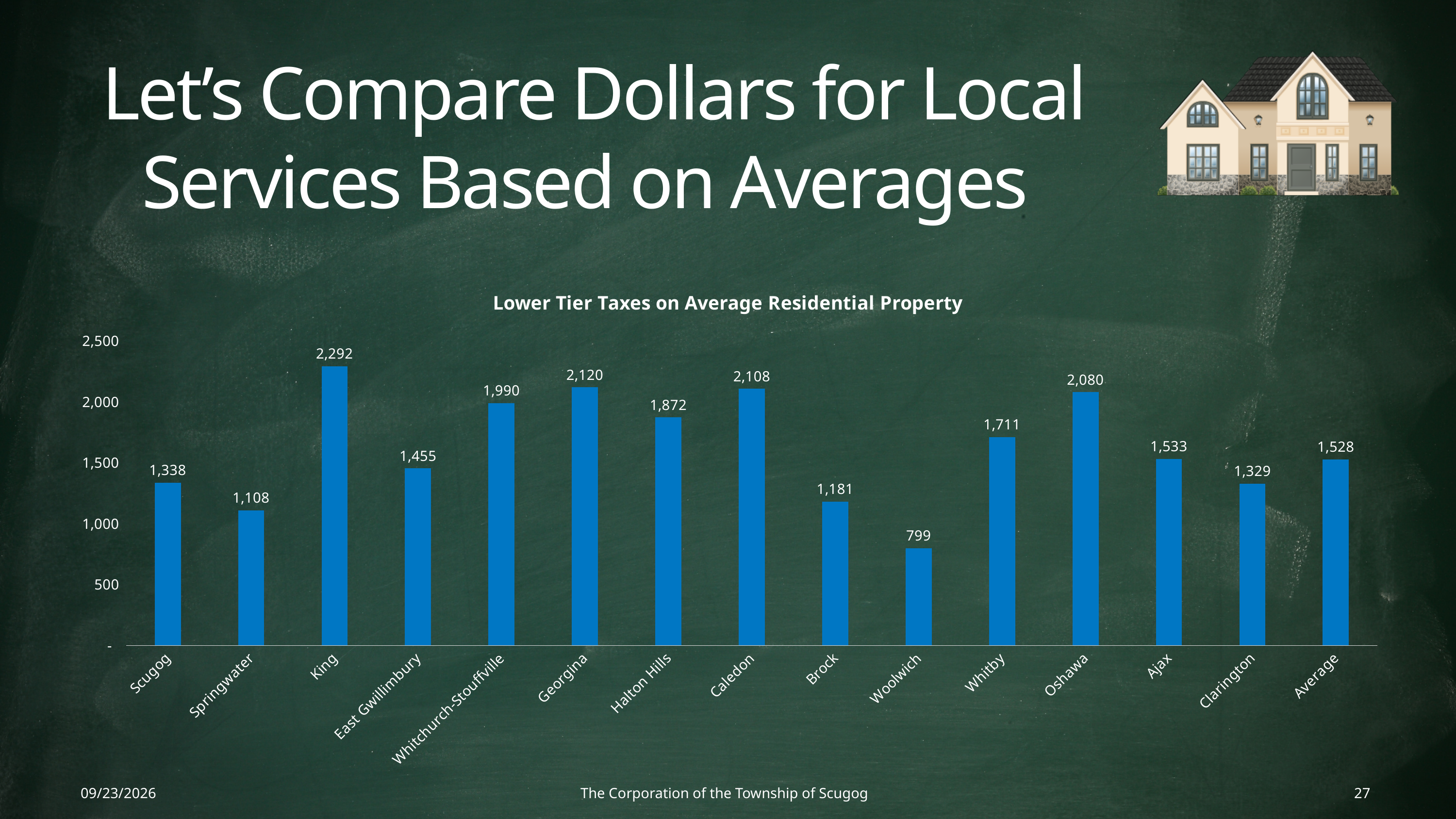
What is the value for Oshawa? 2,080 What is the difference between the values for King and Scugog? 954 What is the value for Woolwich? 799 Which is larger, the value for Georgina or the value for Halton Hills? Georgina What is the difference between the value for Scugog and the Average? 190 Which category has the lowest value? Woolwich Which category has the highest value? King What is the value for Scugog? 1,338 How many categories are shown on the x axis? 15 What kind of chart is shown on the slide? Bar chart What is the title of the chart? Lower Tier Taxes on Average Residential Property Is the value for Brock greater or less than 1,000? greater